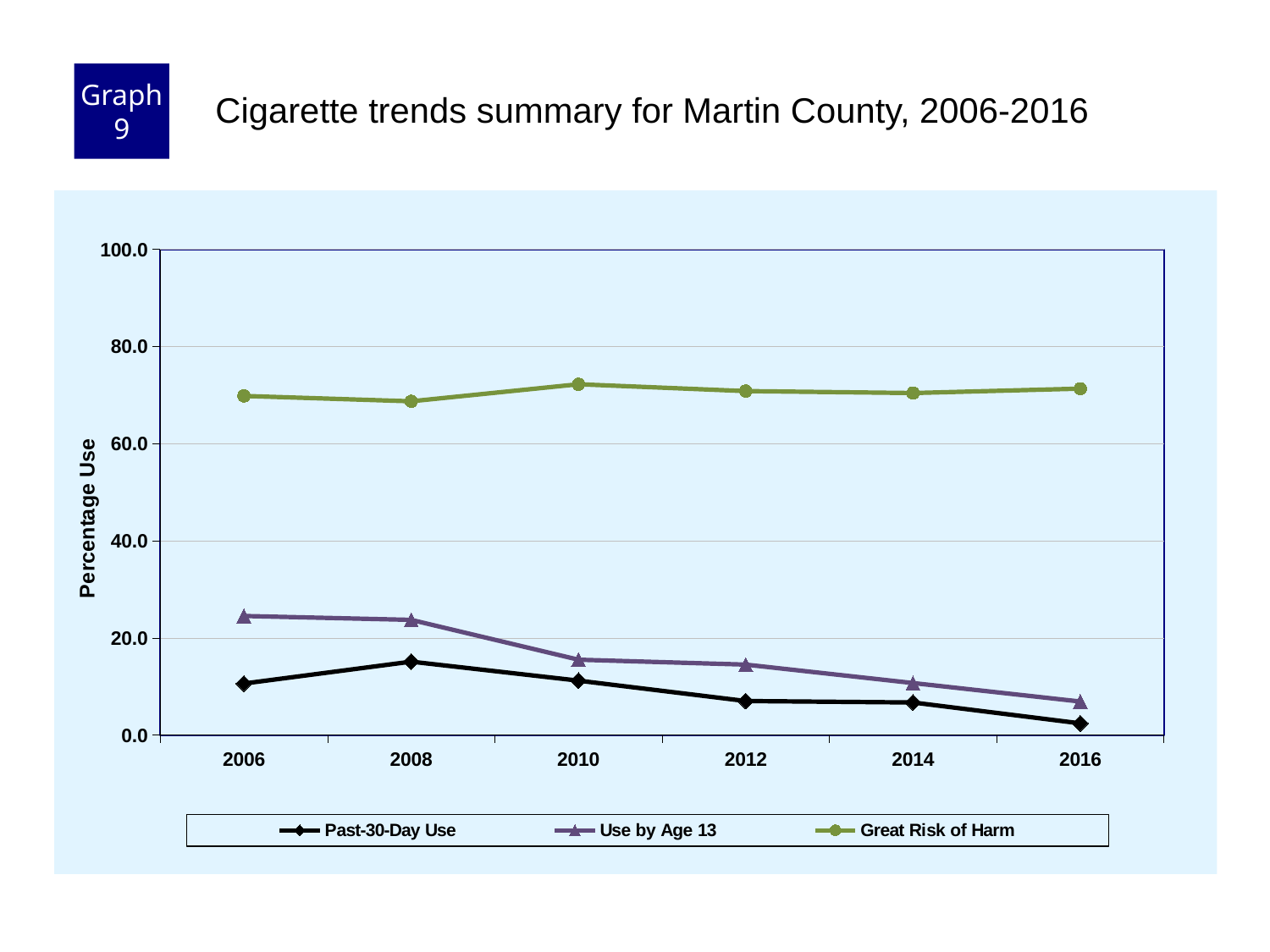
In which year is Past-30-Day Use highest? 2008 Does the Use by Age 13 series rise or fall from 2006 to 2016? fall Is the value for Great Risk of Harm in 2010 greater or less than 80.0? less What is the label on the y axis? Percentage Use Is the value for Past-30-Day Use in 2012 greater or less than 20.0? less How many series does the legend list? 3 In 2006, which is larger: Use by Age 13 or Past-30-Day Use? Use by Age 13 Is the value for Use by Age 13 in 2006 greater or less than 20.0? greater What kind of chart is shown on the slide? line chart In which year is Use by Age 13 lowest? 2016 In which year is Past-30-Day Use lowest? 2016 How many years are plotted along the x axis? 6